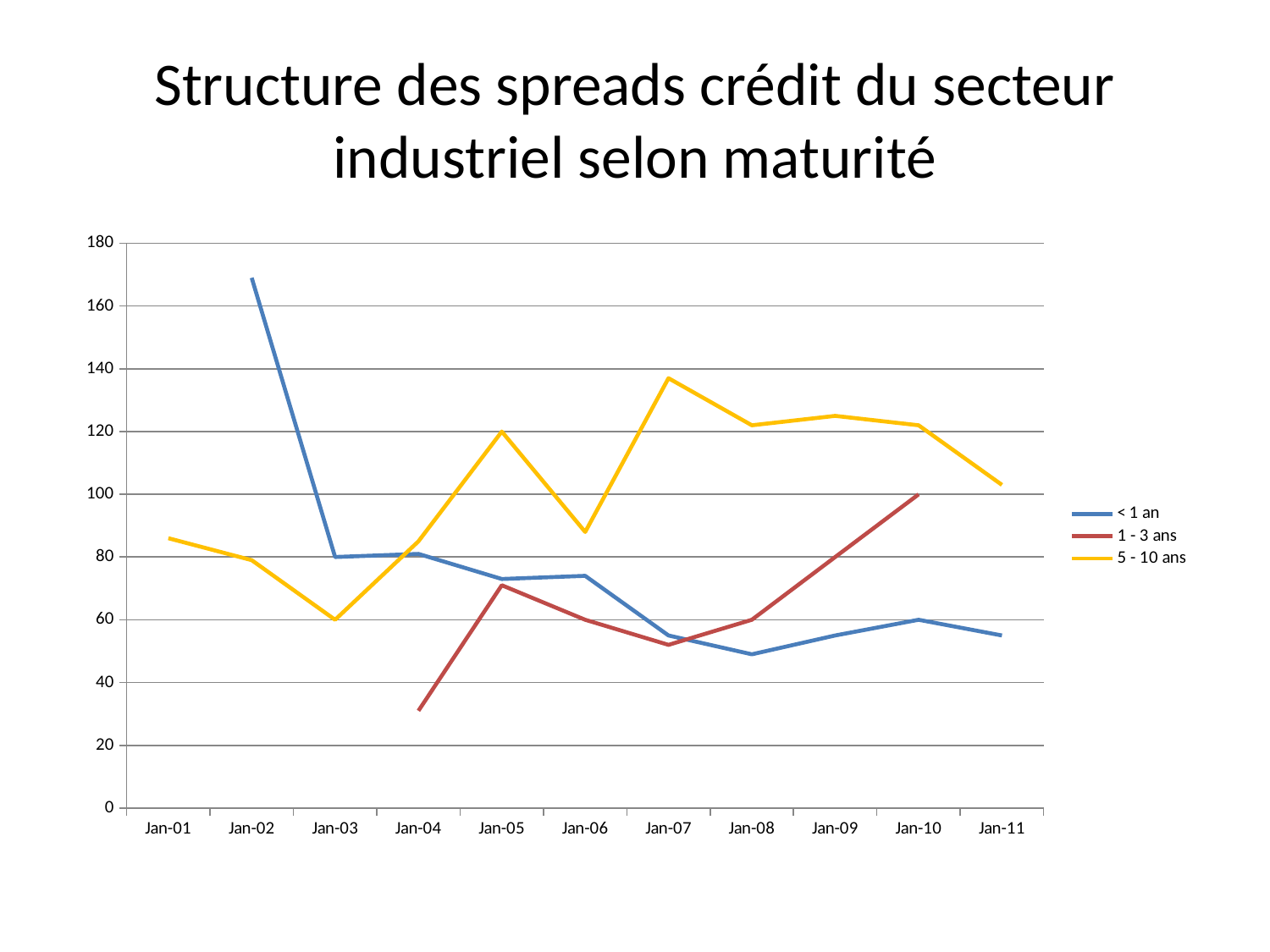
At which date does the '< 1 an' series reach its highest value? Jan-02 What is the title of the chart on the slide? Structure des spreads crédit du secteur industriel selon maturité At which date does the '5 - 10 ans' series reach its lowest value? Jan-03 Is the value for '< 1 an' at Jan-02 greater or less than 160? greater Is the value for '< 1 an' at Jan-08 greater or less than 60? less What kind of chart is shown on the slide? line chart How many series does the legend list? 3 Is the value for '5 - 10 ans' at Jan-07 greater or less than 120? greater Does the '< 1 an' series rise or fall between Jan-02 and Jan-03? fall How many dates are shown on the x axis? 11 At Jan-07, which series has the larger value: '5 - 10 ans' or '< 1 an'? 5 - 10 ans